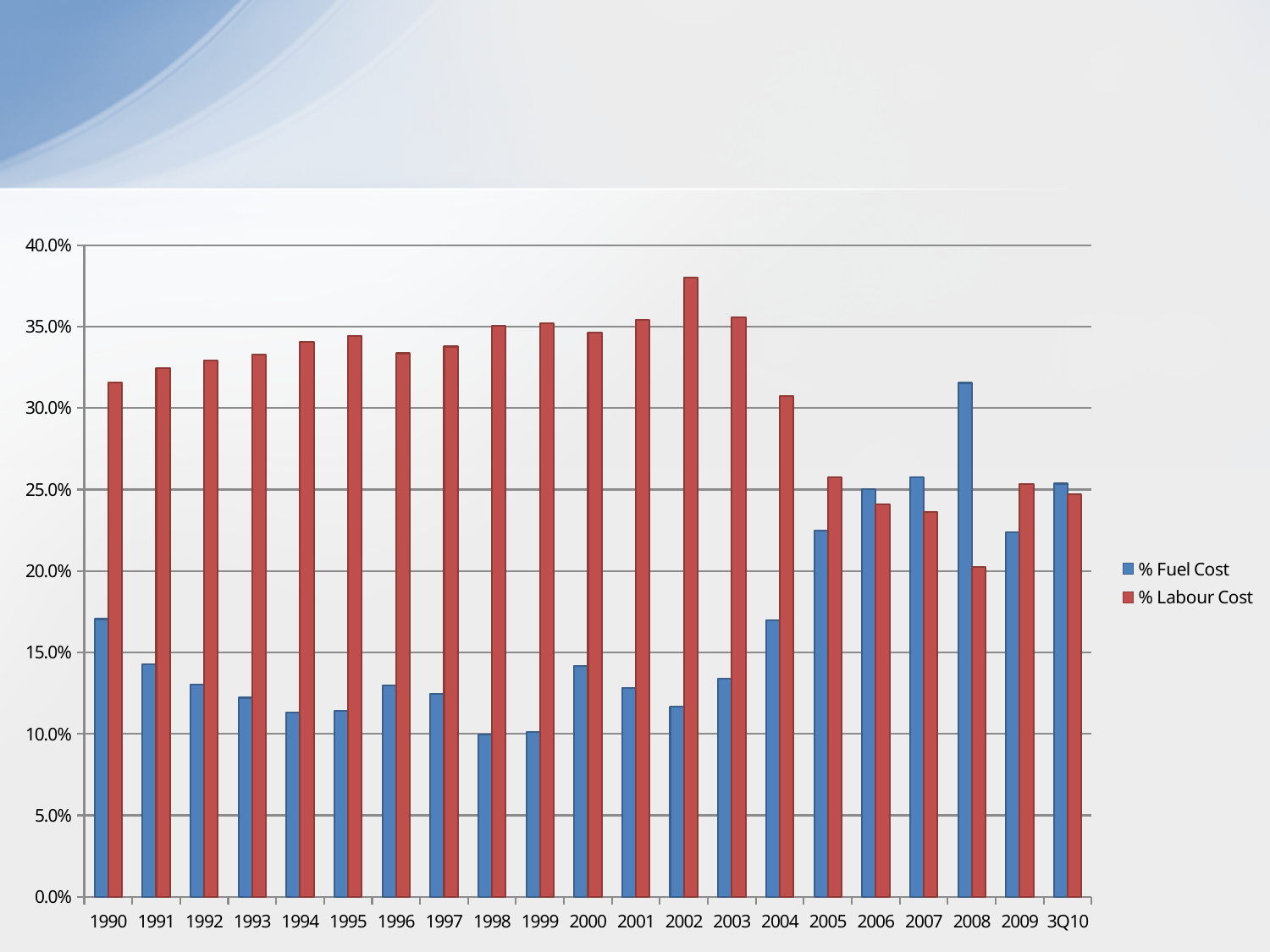
Is the % Fuel Cost for 2004 greater or less than 20.0%? less Which year has the highest % Labour Cost? 2002 Which year has the lowest % Labour Cost? 2008 How many series does the legend list? 2 In 2005, which is larger, % Fuel Cost or % Labour Cost? % Labour Cost Does the % Fuel Cost generally rise or fall from 2004 to 2008? rise Which year has the highest % Fuel Cost? 2008 In 2008, which is larger, % Fuel Cost or % Labour Cost? % Fuel Cost Is the % Labour Cost for 2008 greater or less than 25.0%? less How many categories are shown along the x axis? 21 What kind of chart is shown on the slide? bar chart Is the % Fuel Cost for 2008 greater or less than 30.0%? greater